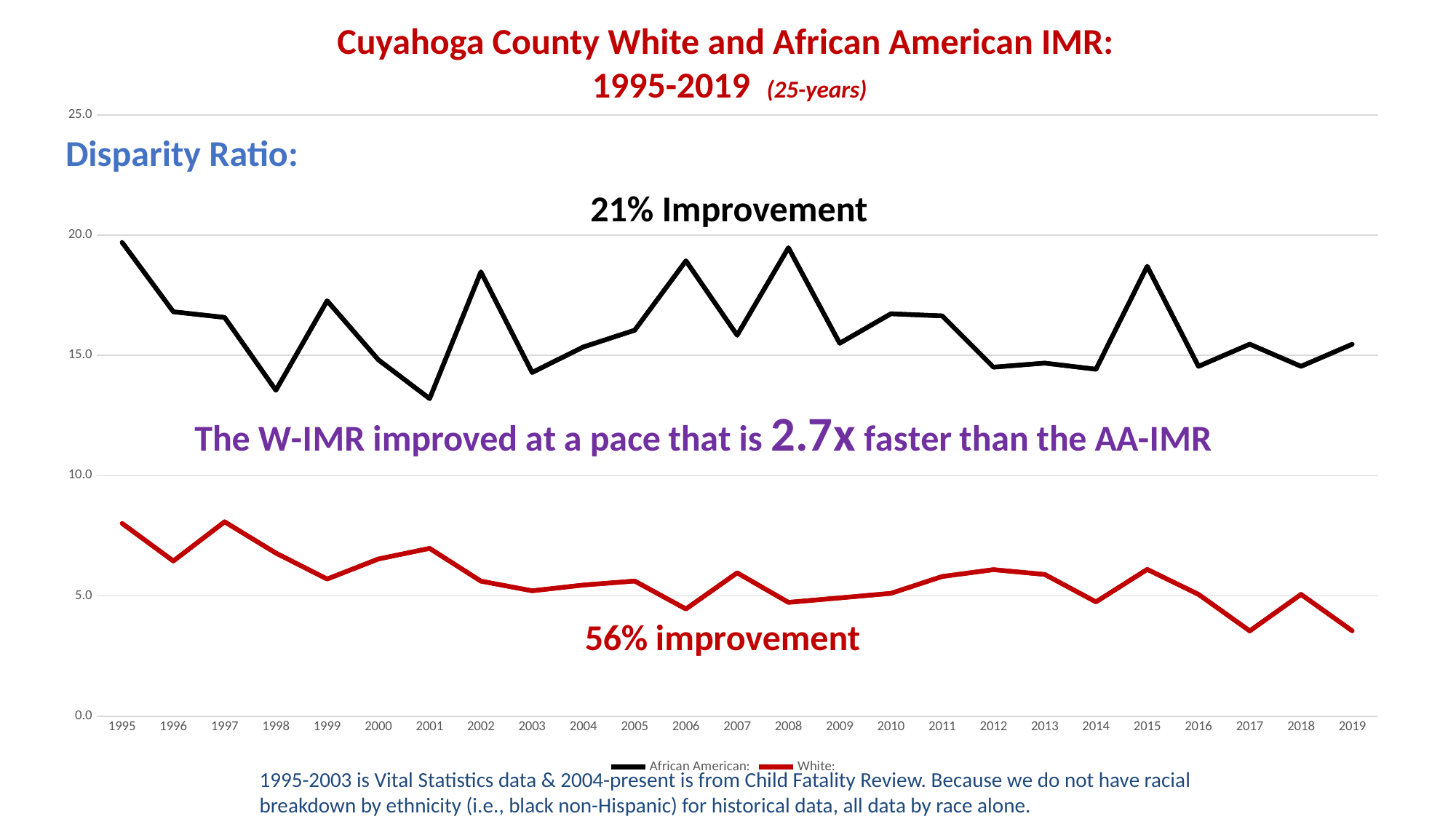
How many series does the legend list? 2 Is the African American value for 1995 greater or less than 15.0? greater Is the White value for 2019 greater or less than 5.0? less What colour is the line for the White series? red What is the title of the chart? Cuyahoga County White and African American IMR: 1995-2019 (25-years) What kind of chart is shown on the slide? line chart How many years are plotted along the x axis? 25 Is the African American value for 2001 greater or less than 15.0? less In 2010, which series has the larger value, African American or White? African American For the White series, which year has the larger value, 1995 or 2019? 1995 Overall, does the White series rise or fall from 1995 to 2019? fall